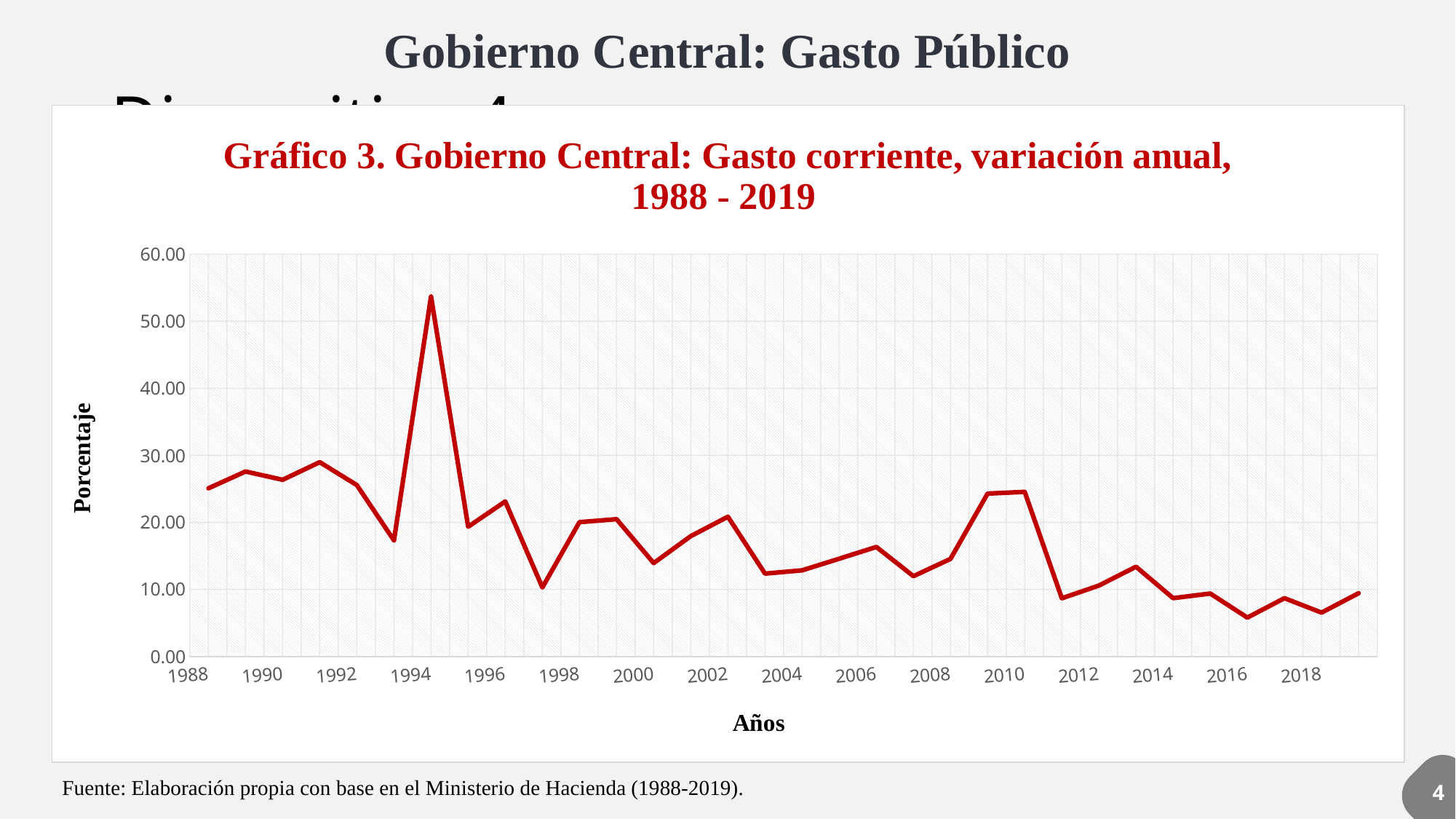
What is the label of the y axis? Porcentaje Is the value for 1993 greater or less than 20? less Which year has the larger value, 1994 or 1995? 1994 Is the value for 2011 greater or less than 10? less Does the line rise or fall between 2008 and 2010? rise Is the value for 2010 greater or less than 20? greater What kind of chart is shown on the slide? line chart What is the label of the x axis? Años Which year has the larger value, 2010 or 2011? 2010 In which year does the line reach its highest value? 1994